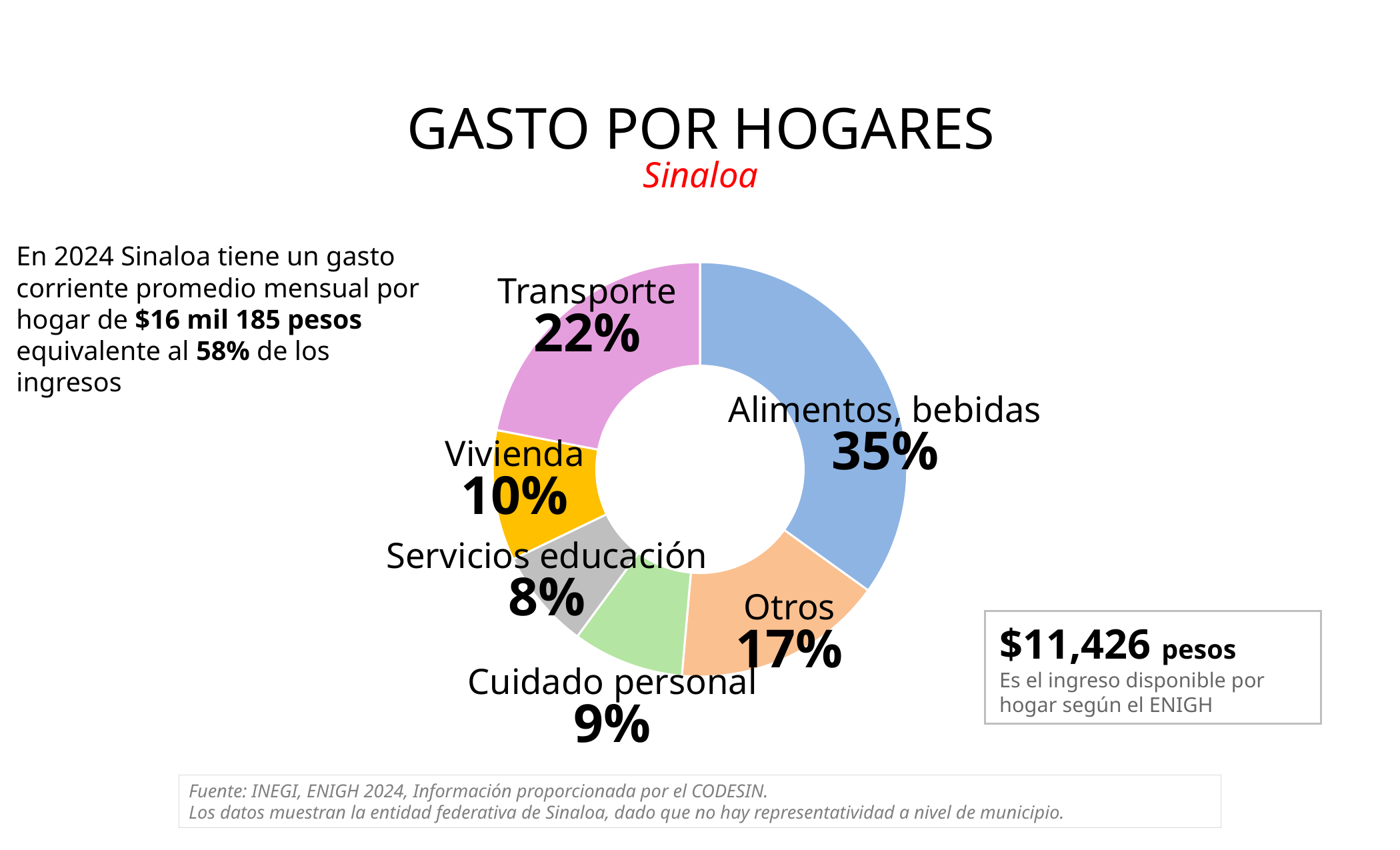
What kind of chart is shown on the slide? Pie chart (doughnut) What colour is the Transporte slice? Pink What share of household spending goes to Alimentos, bebidas? 35% What percentage does the chart show for Transporte? 22% What share does Cuidado personal represent? 9% Which category has the largest share of spending? Alimentos, bebidas What percentage is shown for Servicios educación? 8% What is the value shown for Vivienda? 10% Which category has the smallest share of spending? Servicios educación How many percentage points larger is Alimentos, bebidas than Transporte? 13 Which is larger, Otros or Vivienda? Otros How many categories does the chart show? 6